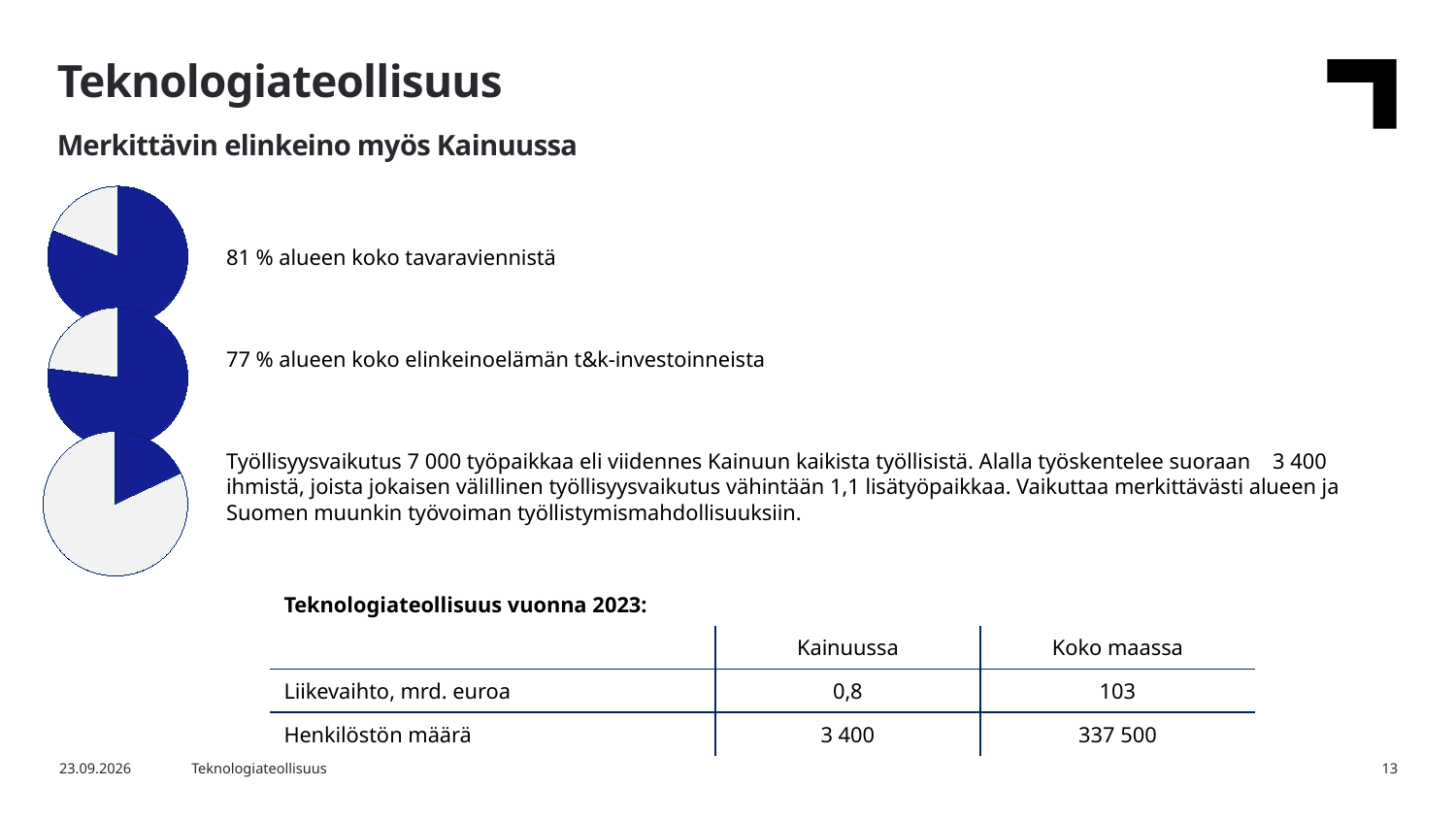
Which of the three pie charts has the smallest dark blue slice? The bottom one (employment effect) How many slices does each pie chart have? 2 What colour is the highlighted slice in each pie chart? Dark blue In the bottom pie chart, is the dark blue slice greater or less than half of the pie? less What is the difference in percentage points between the dark blue share in the top pie chart (81 %) and the middle pie chart (77 %)? 4 percentage points In the top pie chart, what share of the region's total goods exports does the dark blue slice represent? 81 % How many pie charts are on the slide? 3 Which pie chart has the larger dark blue slice, the top one (goods exports) or the middle one (R&D investments)? The top one (goods exports) In the middle pie chart, what share of the region's business R&D investments does the dark blue slice represent? 77 % What is the subtitle of the slide above the pie charts? Merkittävin elinkeino myös Kainuussa What kind of charts are shown on the left side of the slide? Pie charts Which of the three pie charts has the largest dark blue slice? The top one (goods exports)